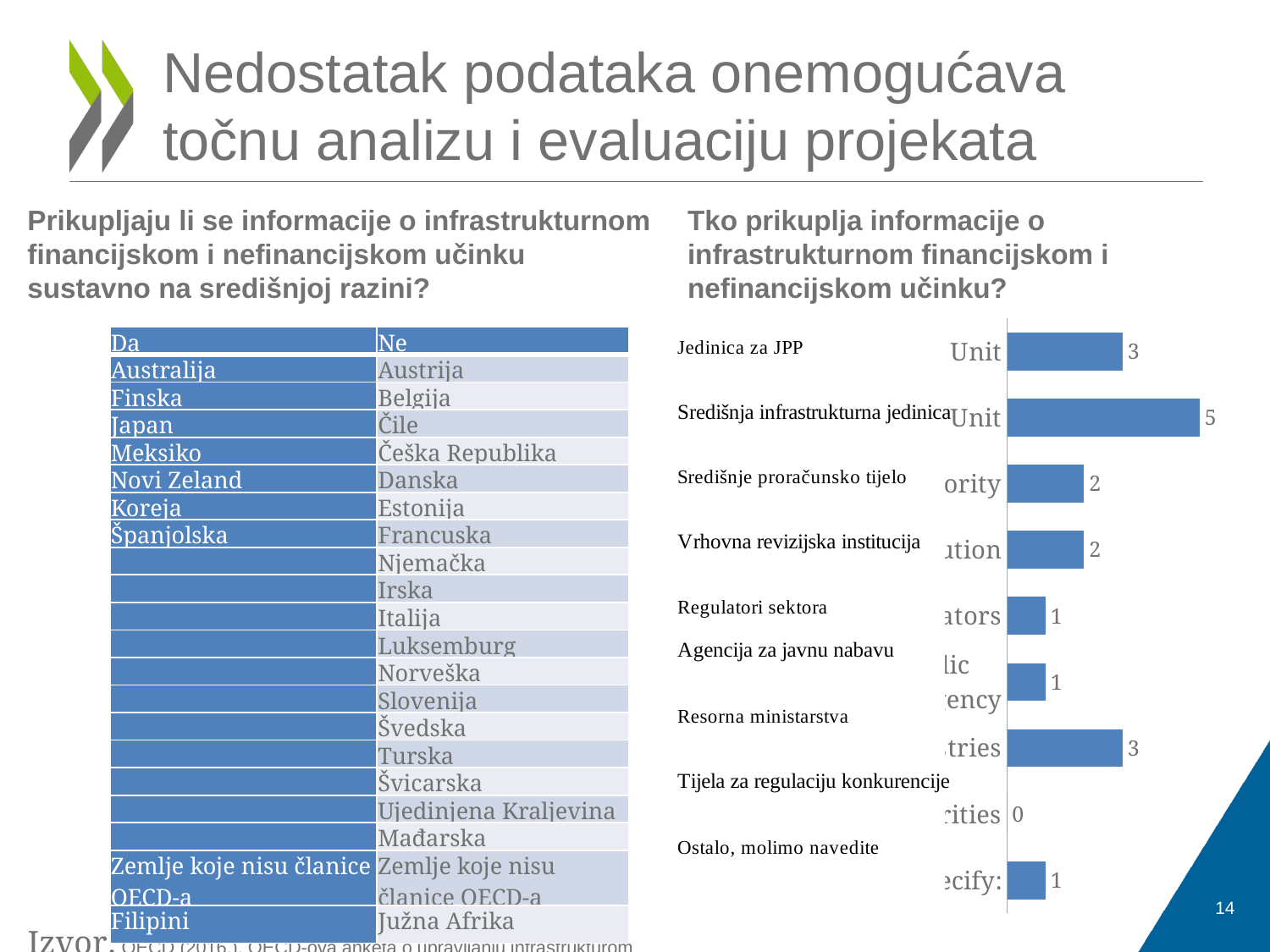
In the bar chart, what is the value for Tijela za regulaciju konkurencije? 0 Which category has the highest value in the bar chart? Središnja infrastrukturna jedinica In the bar chart, what is the value for Središnja infrastrukturna jedinica? 5 Which category has the lowest value in the bar chart? Tijela za regulaciju konkurencije What type of chart is shown on the right side of the slide? bar chart How many categories are plotted in the bar chart? 9 In the bar chart, what is the value for Resorna ministarstva? 3 In the bar chart, what is the difference between the values for Središnja infrastrukturna jedinica and Središnje proračunsko tijelo? 3 What question serves as the heading above the bar chart? Tko prikuplja informacije o infrastrukturnom financijskom i nefinancijskom učinku? In the bar chart, what is the value for Vrhovna revizijska institucija? 2 In the bar chart, what is the value for Jedinica za JPP? 3 In the bar chart, which is larger: the value for Jedinica za JPP or the value for Regulatori sektora? Jedinica za JPP